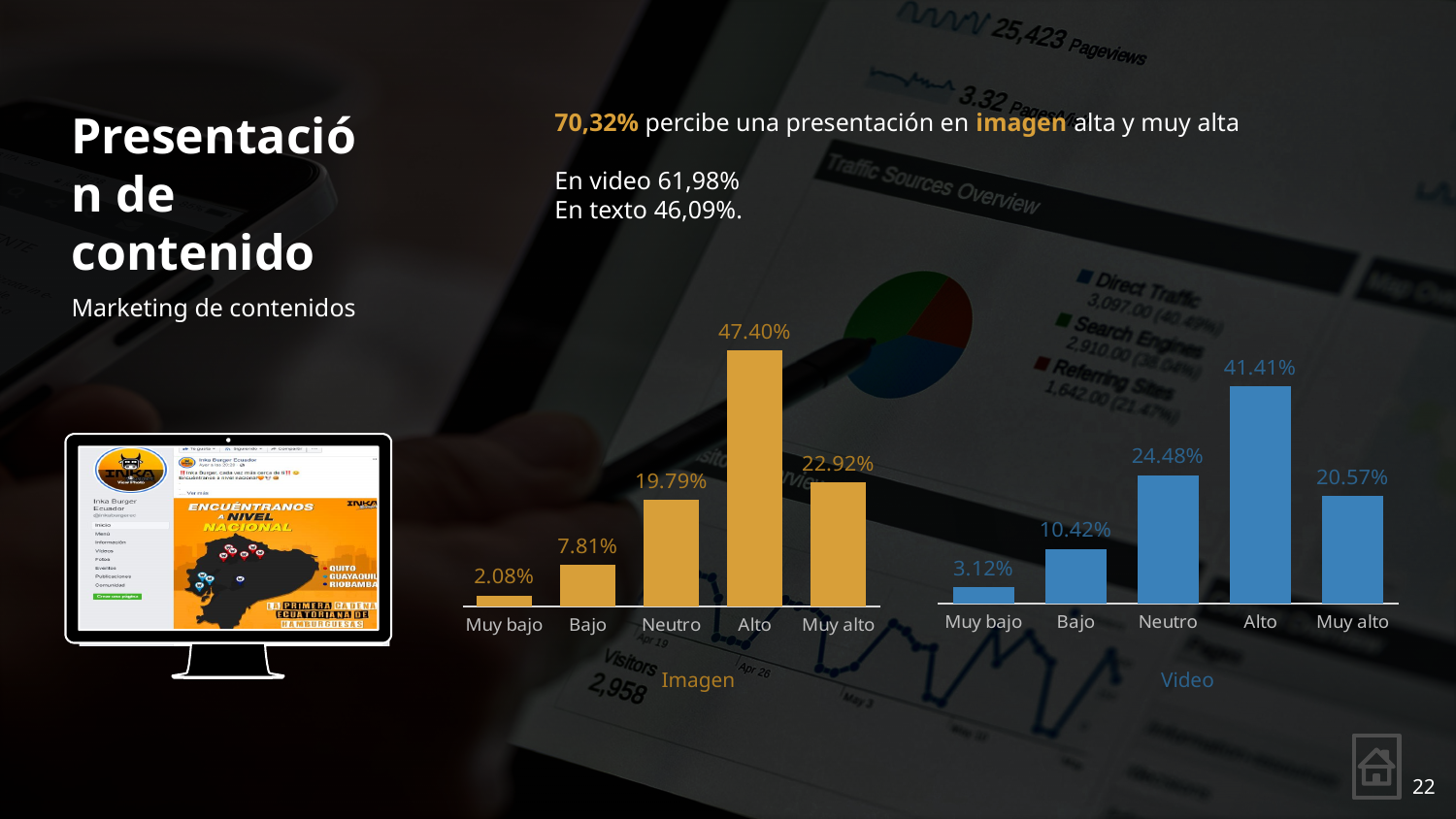
What colour are the bars in the Imagen chart? Orange In the Imagen chart, what is the difference between the values for Alto and Muy alto? 24.48% How many categories does the Imagen chart show? 5 In the Imagen chart, which category has the highest value? Alto In the Video chart, what is the difference between the values for Bajo and Muy bajo? 7.30% In the Video chart, what is the value for Neutro? 24.48% In the Imagen chart, what is the value for Muy bajo? 2.08% In the Video chart, which category has the lowest value? Muy bajo In the Video chart, what is the value for Muy alto? 20.57% Which is larger: the value for Neutro in the Imagen chart or the value for Neutro in the Video chart? Video What type of chart is the Video chart? Bar chart In the Imagen chart, what is the value for Alto? 47.40%